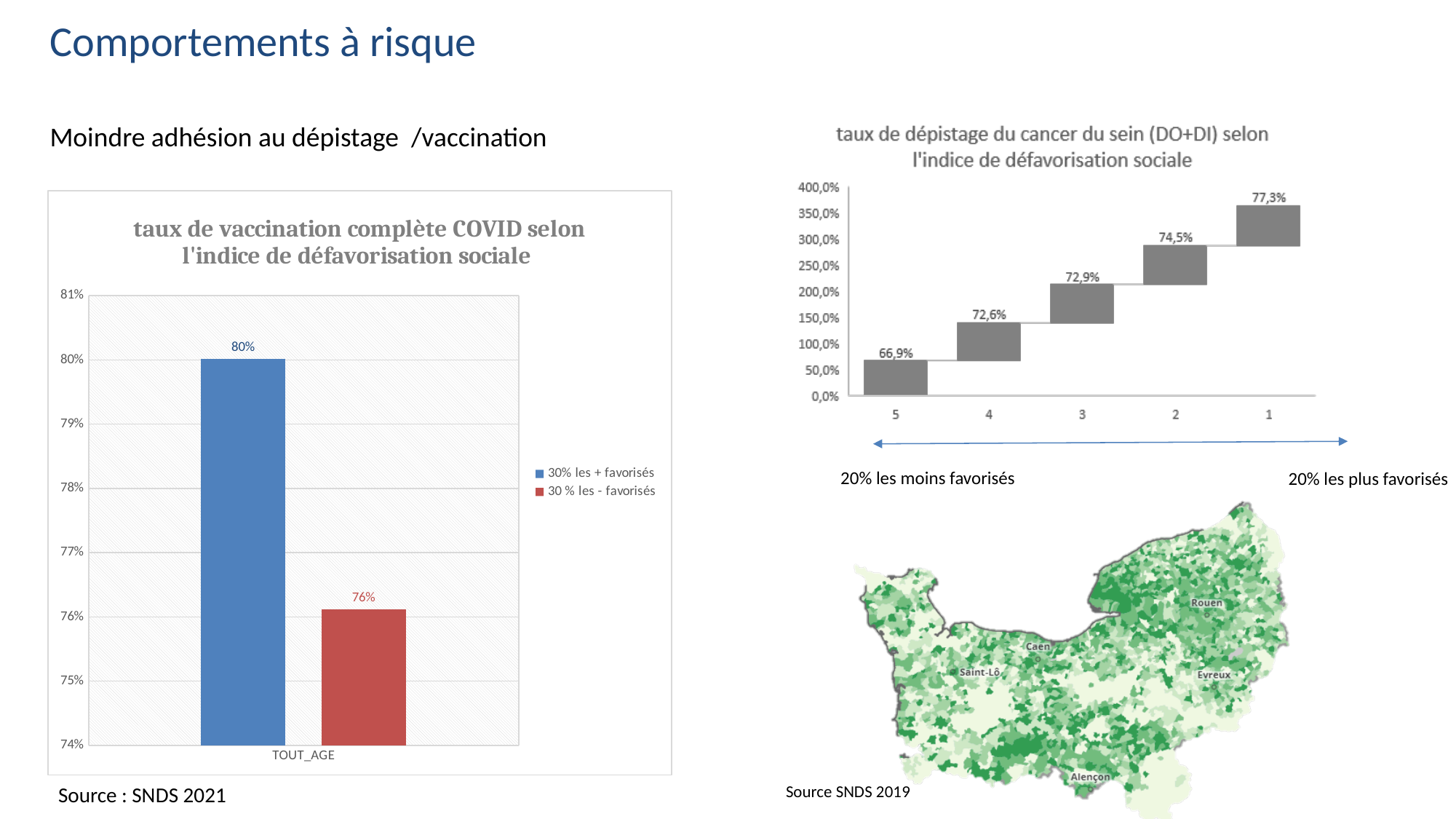
In the chart 'taux de dépistage du cancer du sein (DO+DI) selon l'indice de défavorisation sociale', what is the value labelled for category 5? 66,9% In the chart 'taux de vaccination complète COVID selon l'indice de défavorisation sociale', what is the difference between the two labelled values? 4% In the chart 'taux de vaccination complète COVID selon l'indice de défavorisation sociale', which series has the higher value? 30% les + favorisés In the chart 'taux de dépistage du cancer du sein (DO+DI) selon l'indice de défavorisation sociale', how many categories are shown on the x axis? 5 In the chart 'taux de vaccination complète COVID selon l'indice de défavorisation sociale', what is the value for '30% les + favorisés'? 80% In the chart 'taux de vaccination complète COVID selon l'indice de défavorisation sociale', what is the value for '30 % les - favorisés'? 76% In the chart 'taux de vaccination complète COVID selon l'indice de défavorisation sociale', what is the category label on the x axis? TOUT_AGE In the chart 'taux de dépistage du cancer du sein (DO+DI) selon l'indice de défavorisation sociale', what is the value labelled for category 1? 77,3% In the chart 'taux de dépistage du cancer du sein (DO+DI) selon l'indice de défavorisation sociale', do the labelled values rise or fall from category 5 to category 1? rise In the chart 'taux de vaccination complète COVID selon l'indice de défavorisation sociale', how many series does the legend list? 2 What kind of chart is 'taux de vaccination complète COVID selon l'indice de défavorisation sociale'? bar chart In the chart 'taux de dépistage du cancer du sein (DO+DI) selon l'indice de défavorisation sociale', what is the value labelled for category 3? 72,9%